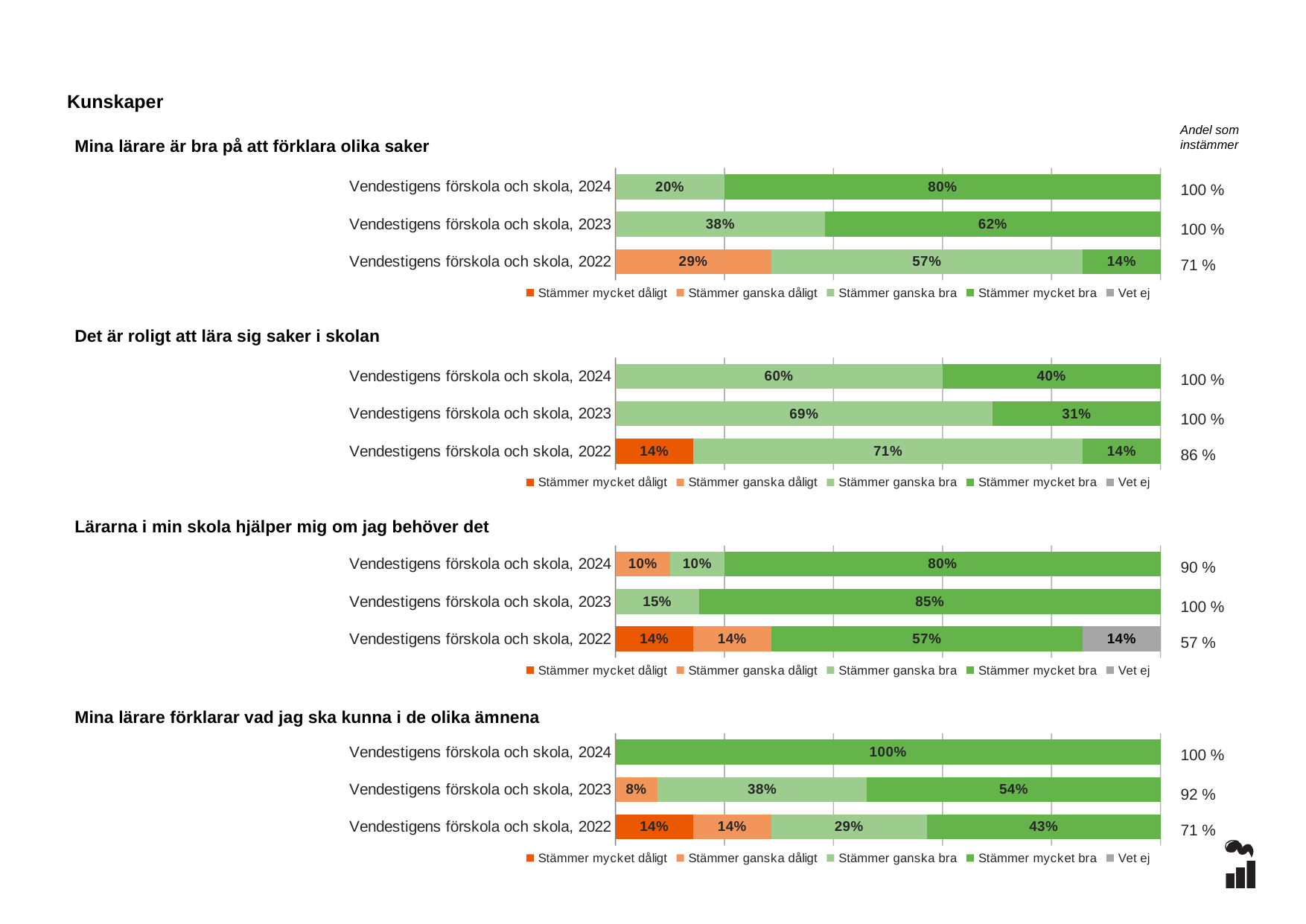
How many bars (rows) does the chart 'Mina lärare förklarar vad jag ska kunna i de olika ämnena' have? 3 In the chart 'Det är roligt att lära sig saker i skolan', what is the 'Andel som instämmer' for Vendestigens förskola och skola, 2022? 86 % In the chart 'Mina lärare är bra på att förklara olika saker', what is the 'Stämmer ganska dåligt' value for Vendestigens förskola och skola, 2022? 29% How many series does the legend of the chart 'Det är roligt att lära sig saker i skolan' list? 5 In the chart 'Det är roligt att lära sig saker i skolan', what is the 'Stämmer ganska bra' value for Vendestigens förskola och skola, 2023? 69% In the chart 'Mina lärare är bra på att förklara olika saker', what is the 'Stämmer mycket bra' value for Vendestigens förskola och skola, 2024? 80% In the chart 'Lärarna i min skola hjälper mig om jag behöver det', what is the 'Vet ej' value for Vendestigens förskola och skola, 2022? 14% In the chart 'Det är roligt att lära sig saker i skolan', what is the difference between the 'Stämmer ganska bra' values for 2023 and 2024? 9% In the chart 'Mina lärare förklarar vad jag ska kunna i de olika ämnena', what is the 'Stämmer ganska bra' value for Vendestigens förskola och skola, 2022? 29% In the chart 'Mina lärare förklarar vad jag ska kunna i de olika ämnena', what is the 'Stämmer mycket bra' value for Vendestigens förskola och skola, 2024? 100% In the chart 'Lärarna i min skola hjälper mig om jag behöver det', which is larger: the 'Stämmer mycket bra' value for 2023 or for 2024? 2023 In the chart 'Mina lärare är bra på att förklara olika saker', which year has the highest 'Stämmer mycket bra' value? 2024